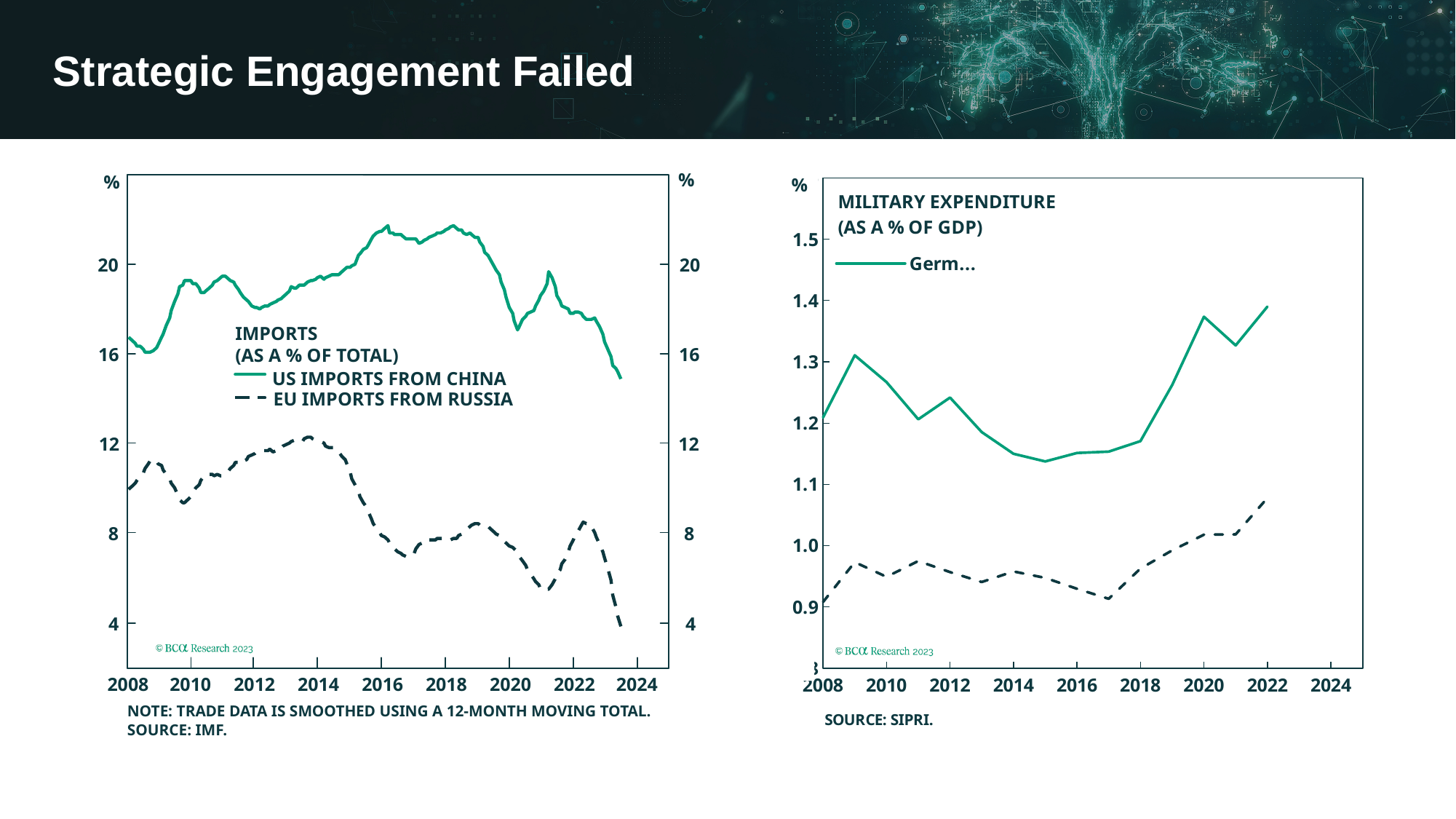
In the left chart 'IMPORTS (AS A % OF TOTAL)', which series is higher in 2020, US IMPORTS FROM CHINA or EU IMPORTS FROM RUSSIA? US IMPORTS FROM CHINA In the right chart 'MILITARY EXPENDITURE (AS A % OF GDP)', is the value of the solid line in 2020 greater or less than 1.3? greater In the right chart 'MILITARY EXPENDITURE (AS A % OF GDP)', does the solid line rise or fall from 2018 to 2022? rise In the left chart 'IMPORTS (AS A % OF TOTAL)', is the value for EU IMPORTS FROM RUSSIA in 2010 greater or less than 8? greater In the right chart 'MILITARY EXPENDITURE (AS A % OF GDP)', is the value of the solid line in 2015 greater or less than 1.2? less In the left chart 'IMPORTS (AS A % OF TOTAL)', does the US IMPORTS FROM CHINA series rise or fall from 2018 to 2023? fall How many series does the legend of the left chart 'IMPORTS (AS A % OF TOTAL)' list? 2 What kind of chart is the left chart titled 'IMPORTS (AS A % OF TOTAL)'? line chart What kind of chart is the right chart titled 'MILITARY EXPENDITURE (AS A % OF GDP)'? line chart What source is cited below the left chart 'IMPORTS (AS A % OF TOTAL)'? IMF